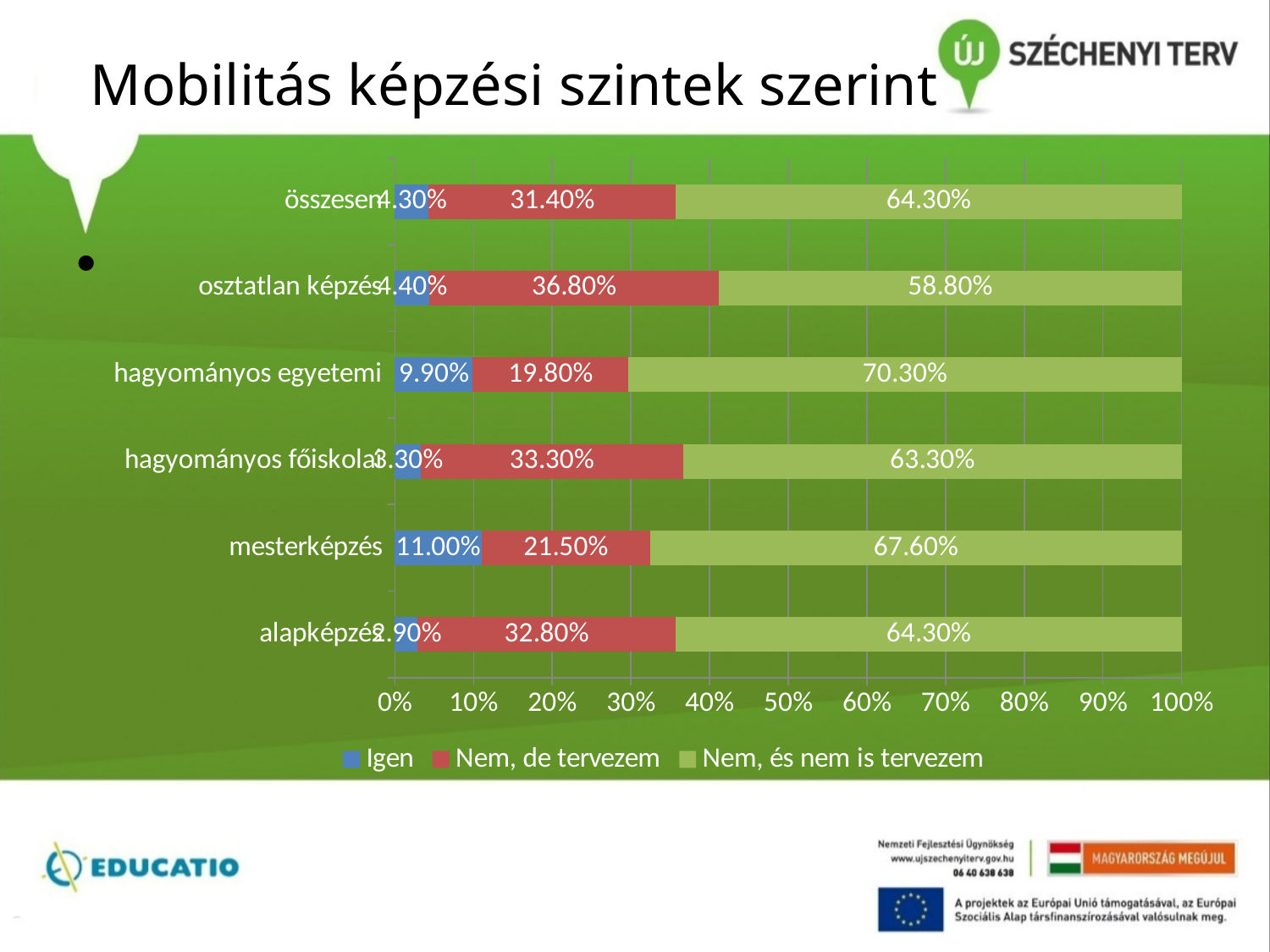
What is the difference between the "Nem, de tervezem" values for osztatlan képzés and hagyományos egyetemi? 17.00% How many categories are plotted on the chart? 6 What kind of chart is shown on the slide? stacked bar chart Which category has the highest "Igen" value? mesterképzés Which category has the lowest "Nem, és nem is tervezem" value? osztatlan képzés What is the value of "Igen" for mesterképzés? 11.00% How many series does the legend list? 3 What is the title of the slide containing the chart? Mobilitás képzési szintek szerint Is the "Nem, és nem is tervezem" value for mesterképzés greater or less than 60%? greater What is the value of "Nem, de tervezem" for osztatlan képzés? 36.80% What is the value of "Nem, és nem is tervezem" for hagyományos egyetemi? 70.30% Which is larger: the "Igen" value for hagyományos egyetemi or for hagyományos főiskolai? hagyományos egyetemi